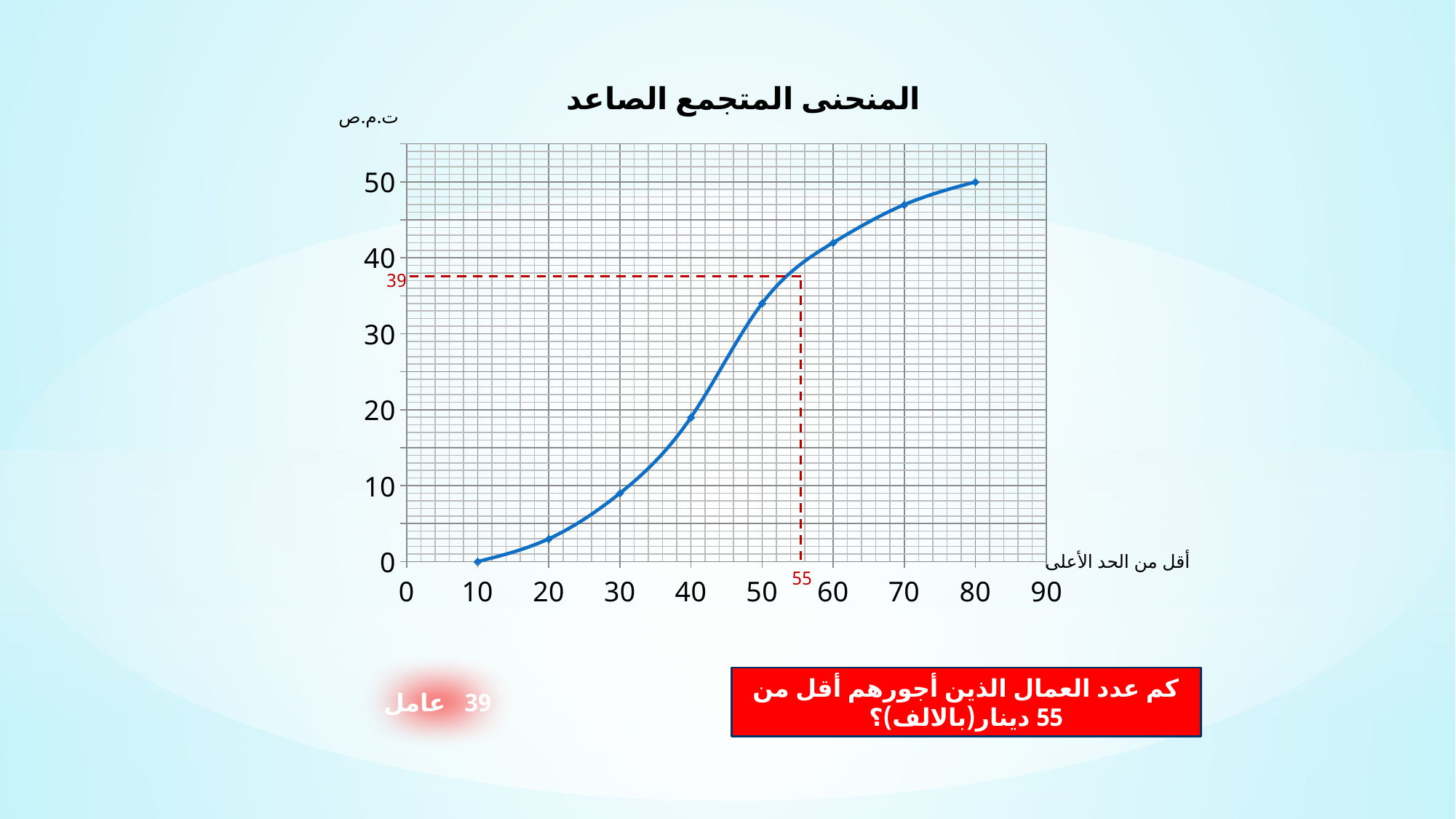
According to the red dashed lines, what cumulative value corresponds to x = 55? 39 How many data points are plotted on the curve? 8 Is the value at x = 50 greater or less than 30? greater What is the title of the chart? المنحنى المتجمع الصاعد At which x value is the curve at its lowest point? 10 What is the cumulative value at x = 80? 50 Is the value at x = 20 greater or less than 10? less What is the cumulative value at x = 10? 0 Is the value at x = 70 greater or less than 40? greater What kind of chart is shown on the slide? line chart Do the values rise or fall as the x axis increases? rise At which x value does the curve reach its highest point? 80